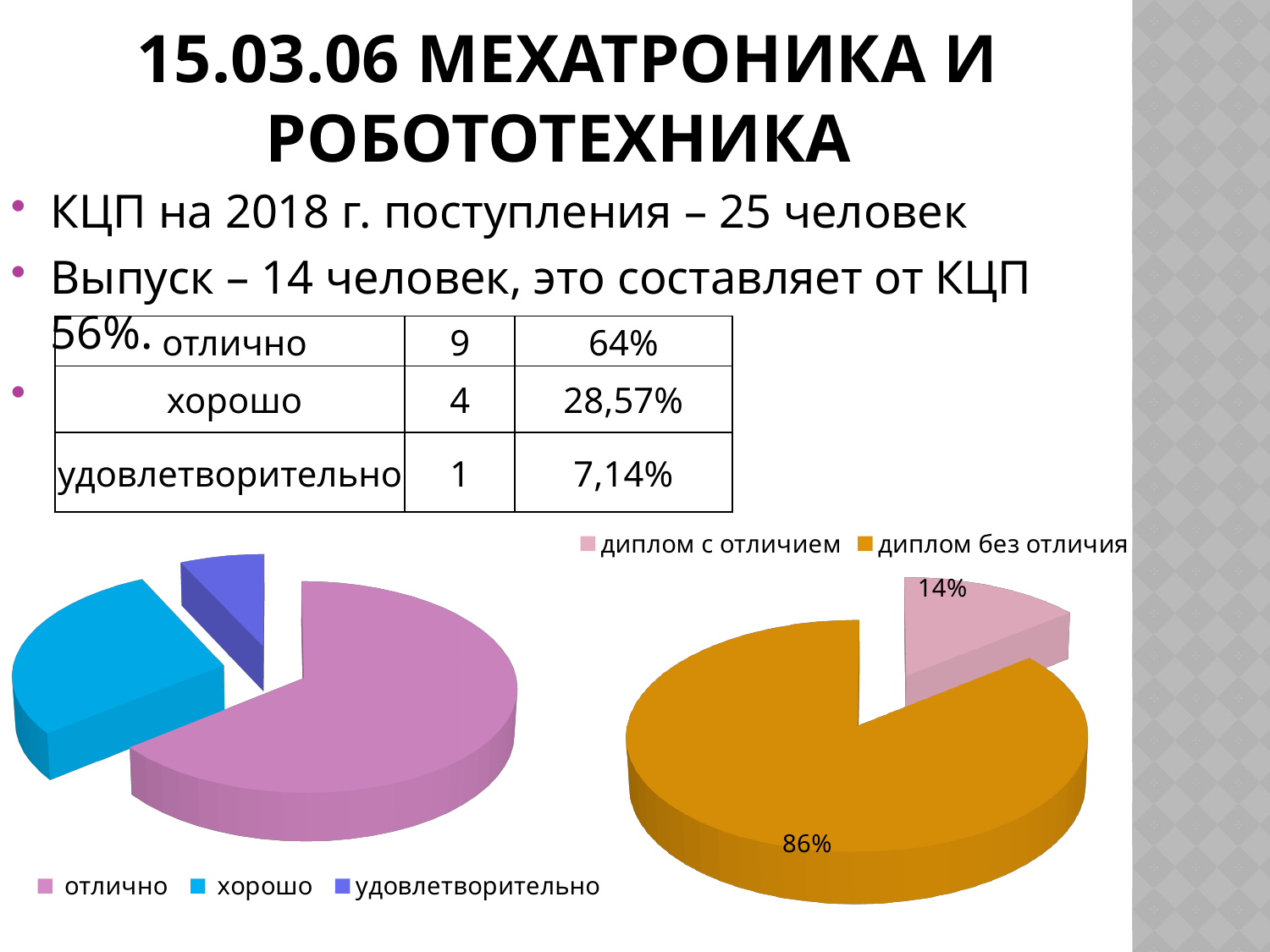
How many categories does the left pie chart show? 3 In the right pie chart, what share is shown for "диплом без отличия"? 86% In the left pie chart, what colour is the "хорошо" slice? Blue In the left pie chart, which category has the smallest slice? удовлетворительно How many entries does the legend of the right chart list? 2 In the right pie chart, what share is shown for "диплом с отличием"? 14% How many slices does the right pie chart have? 2 In the left pie chart, which category has the largest slice? отлично In the left pie chart, which slice is larger: "хорошо" or "удовлетворительно"? хорошо In the right pie chart, which slice is larger: "диплом с отличием" or "диплом без отличия"? диплом без отличия What type of chart is the left chart on the slide? Pie chart In the right pie chart, what is the difference in percentage points between "диплом без отличия" and "диплом с отличием"? 72 percentage points